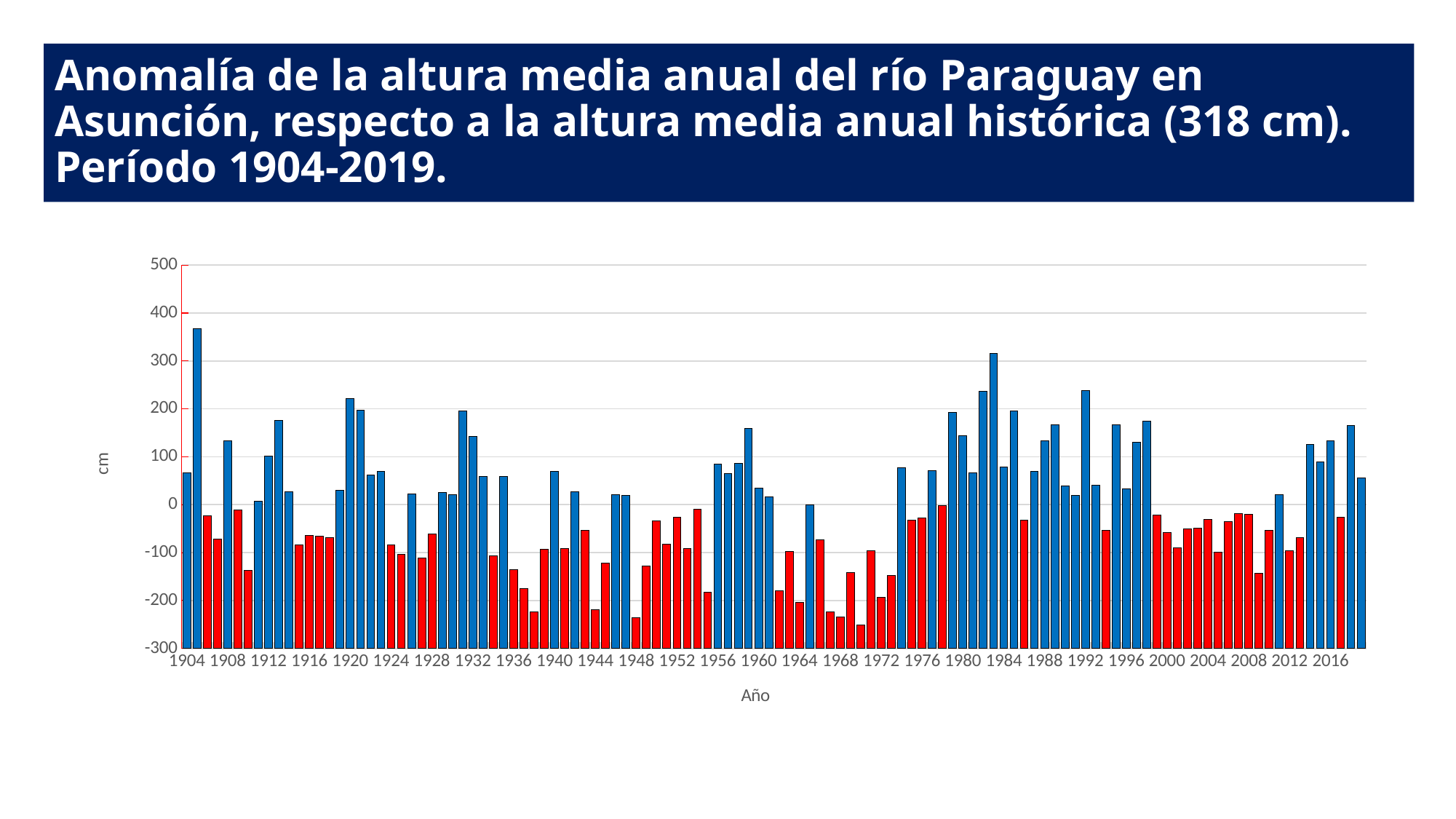
Is the value for 1920 greater or less than 200? greater Which is larger, the value for 1920 or the value for 1904? 1920 What unit is shown on the y axis of the chart? cm What kind of chart is shown on the slide? bar chart Is the value for 1948 greater or less than -200? less Is the value for 1904 greater or less than 100? less Which is larger, the value for 1905 or the value for 1983? 1905 Which year has the highest bar in the chart? 1905 What is the label of the x axis of the chart? Año